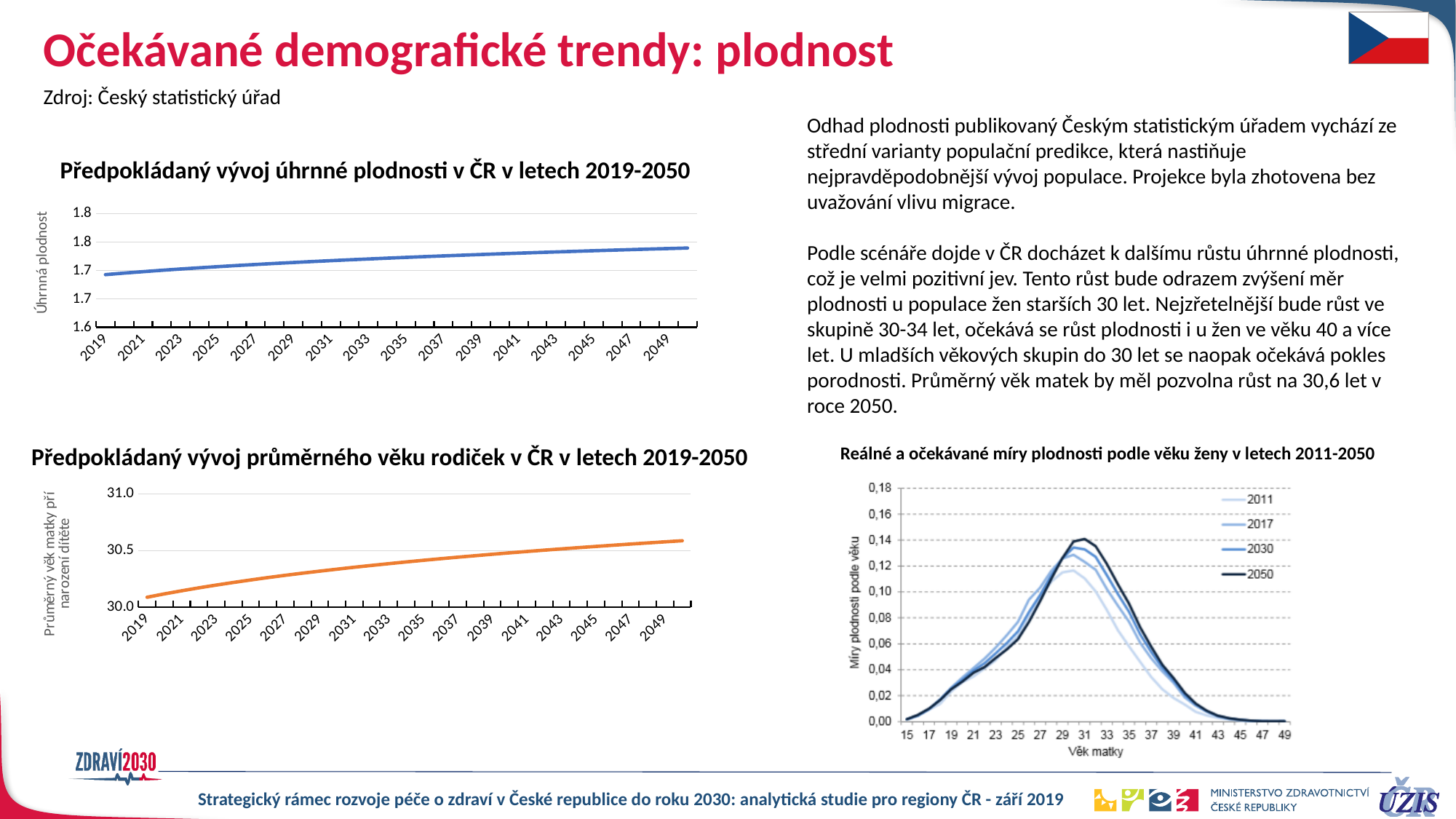
In the chart "Předpokládaný vývoj průměrného věku rodiček v ČR v letech 2019-2050", is the value for 2049 greater or less than 31.0? less In the chart "Předpokládaný vývoj průměrného věku rodiček v ČR v letech 2019-2050", is the value for 2019 greater or less than 30.5? less In the chart "Předpokládaný vývoj průměrného věku rodiček v ČR v letech 2019-2050", which is larger, the value for 2019 or the value for 2049? 2049 In the chart "Reálné a očekávané míry plodnosti podle věku ženy v letech 2011-2050", is the peak value of the 2050 series greater or less than 0,12? greater In the chart "Předpokládaný vývoj průměrného věku rodiček v ČR v letech 2019-2050", do the values rise or fall along the x axis? rise In the chart "Reálné a očekávané míry plodnosti podle věku ženy v letech 2011-2050", which series has the higher value at age 31, 2011 or 2050? 2050 In the chart "Reálné a očekávané míry plodnosti podle věku ženy v letech 2011-2050", which series reaches the highest peak value? 2050 In the chart "Předpokládaný vývoj úhrnné plodnosti v ČR v letech 2019-2050", do the values rise or fall from 2019 to 2049? rise What is the x-axis label of the chart "Reálné a očekávané míry plodnosti podle věku ženy v letech 2011-2050"? Věk matky What kind of chart is "Předpokládaný vývoj úhrnné plodnosti v ČR v letech 2019-2050"? line chart How many series does the legend list in the chart "Reálné a očekávané míry plodnosti podle věku ženy v letech 2011-2050"? 4